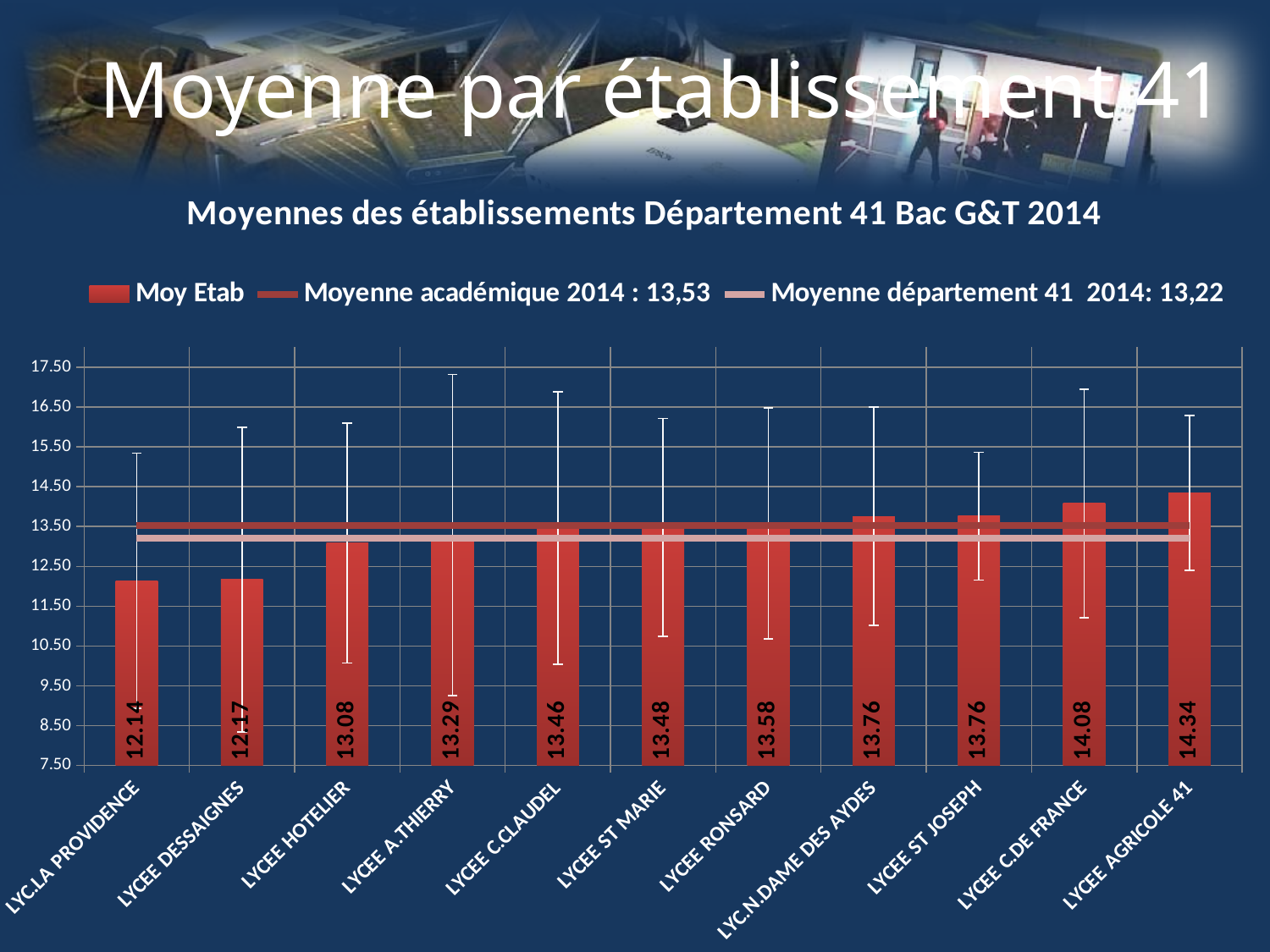
Is the value for LYCEE DESSAIGNES greater or less than 12.50? less Which establishment has the highest value? LYCEE AGRICOLE 41 What is the difference between the values for LYCEE AGRICOLE 41 and LYC.LA PROVIDENCE? 2.20 What kind of chart is shown? combination bar and line chart Which establishment has the lowest value? LYC.LA PROVIDENCE What is the value for LYCEE HOTELIER? 13.08 How many establishments are shown on the x axis? 11 What is the value for LYCEE C.DE FRANCE? 14.08 What is the title of the chart? Moyennes des établissements Département 41 Bac G&T 2014 Which has a larger value, LYCEE A.THIERRY or LYCEE ST MARIE? LYCEE ST MARIE How many entries does the legend list? 3 What is the value for LYCEE RONSARD? 13.58